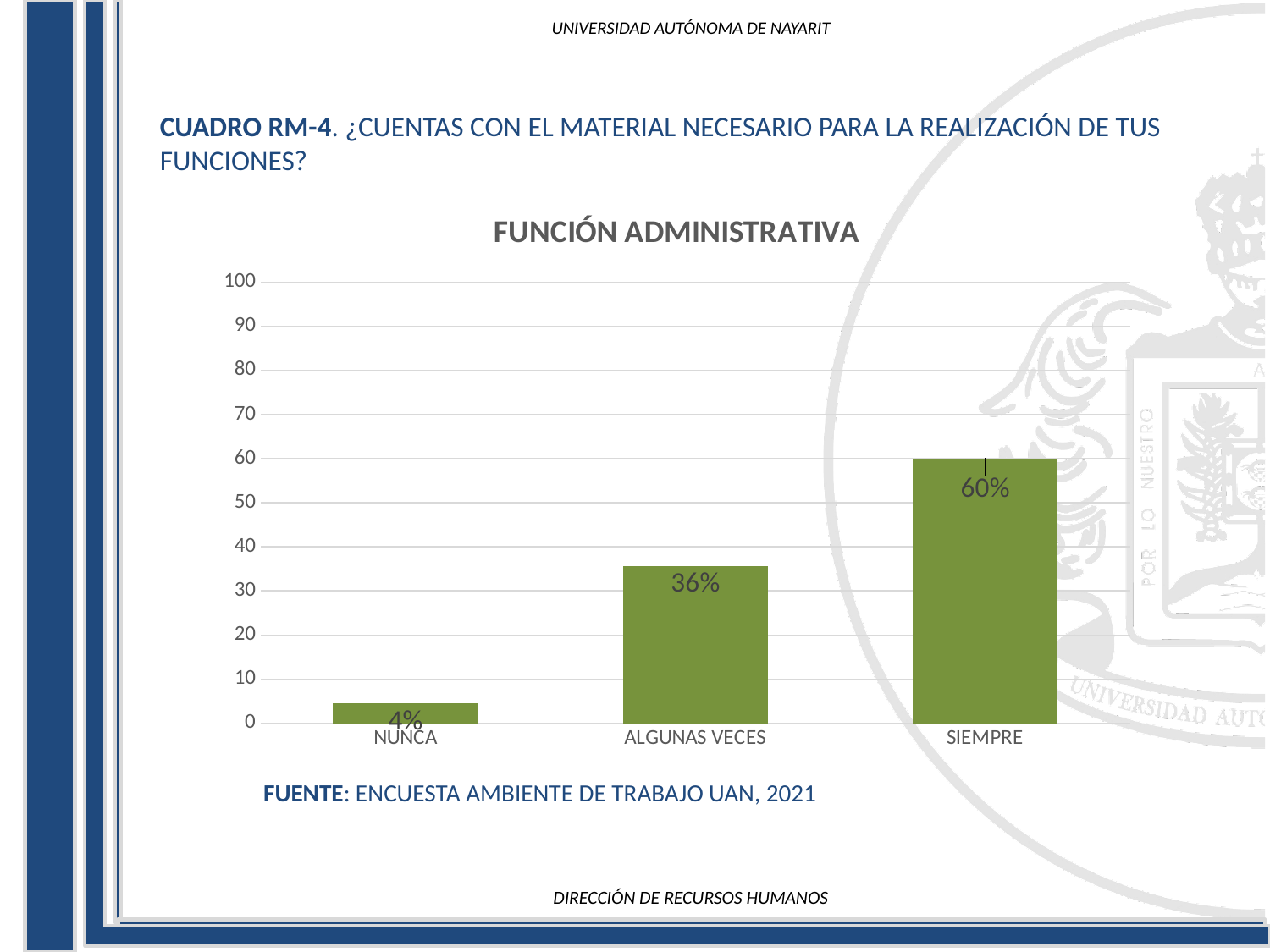
What kind of chart is shown? bar chart What is the value for NUNCA? 4% What is the value for ALGUNAS VECES? 36% What is the title of the chart? FUNCIÓN ADMINISTRATIVA How many categories are shown on the x axis? 3 What is the value for SIEMPRE? 60% What is the difference between the values for SIEMPRE and ALGUNAS VECES? 24% Which is larger, the value for ALGUNAS VECES or the value for NUNCA? ALGUNAS VECES Is the value for SIEMPRE greater or less than 50? greater Which category has the highest value? SIEMPRE What is the difference between the values for ALGUNAS VECES and NUNCA? 32% Which category has the lowest value? NUNCA